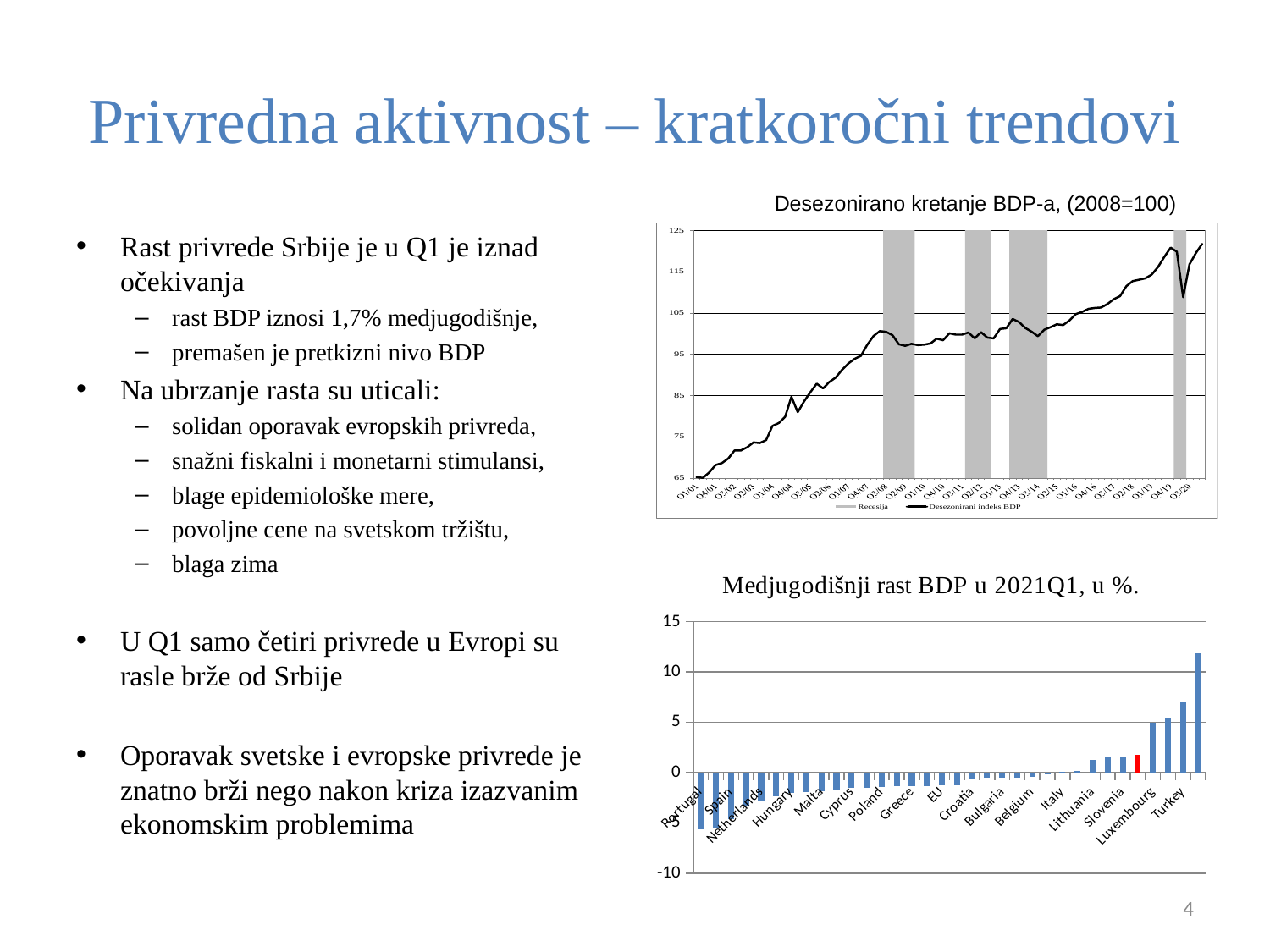
In the bottom chart 'Medjugodišnji rast BDP u 2021Q1', is the value for Spain greater or less than 0? less In the top chart 'Desezonirano kretanje BDP-a', is the value at Q3/20 greater or less than 115? greater In the bottom chart 'Medjugodišnji rast BDP u 2021Q1', do the bar values rise or fall from left to right? rise What kind of chart is the bottom chart, 'Medjugodišnji rast BDP u 2021Q1, u %.'? bar chart In the top chart 'Desezonirano kretanje BDP-a', does the index overall rise or fall from Q1/01 to Q3/20? rise What are the two legend entries of the top chart 'Desezonirano kretanje BDP-a'? Recesija and Desezonirani indeks BDP In the bottom chart 'Medjugodišnji rast BDP u 2021Q1', which labelled country has the lowest value? Portugal In the bottom chart 'Medjugodišnji rast BDP u 2021Q1', which is larger, the value for Italy or the value for Spain? Italy How many series does the legend of the top chart 'Desezonirano kretanje BDP-a' list? 2 In the bottom chart 'Medjugodišnji rast BDP u 2021Q1', is the value for Turkey greater or less than 5? greater In the bottom chart 'Medjugodišnji rast BDP u 2021Q1', which is larger, the value for Turkey or the value for Portugal? Turkey What kind of chart is the top chart, 'Desezonirano kretanje BDP-a, (2008=100)'? line chart